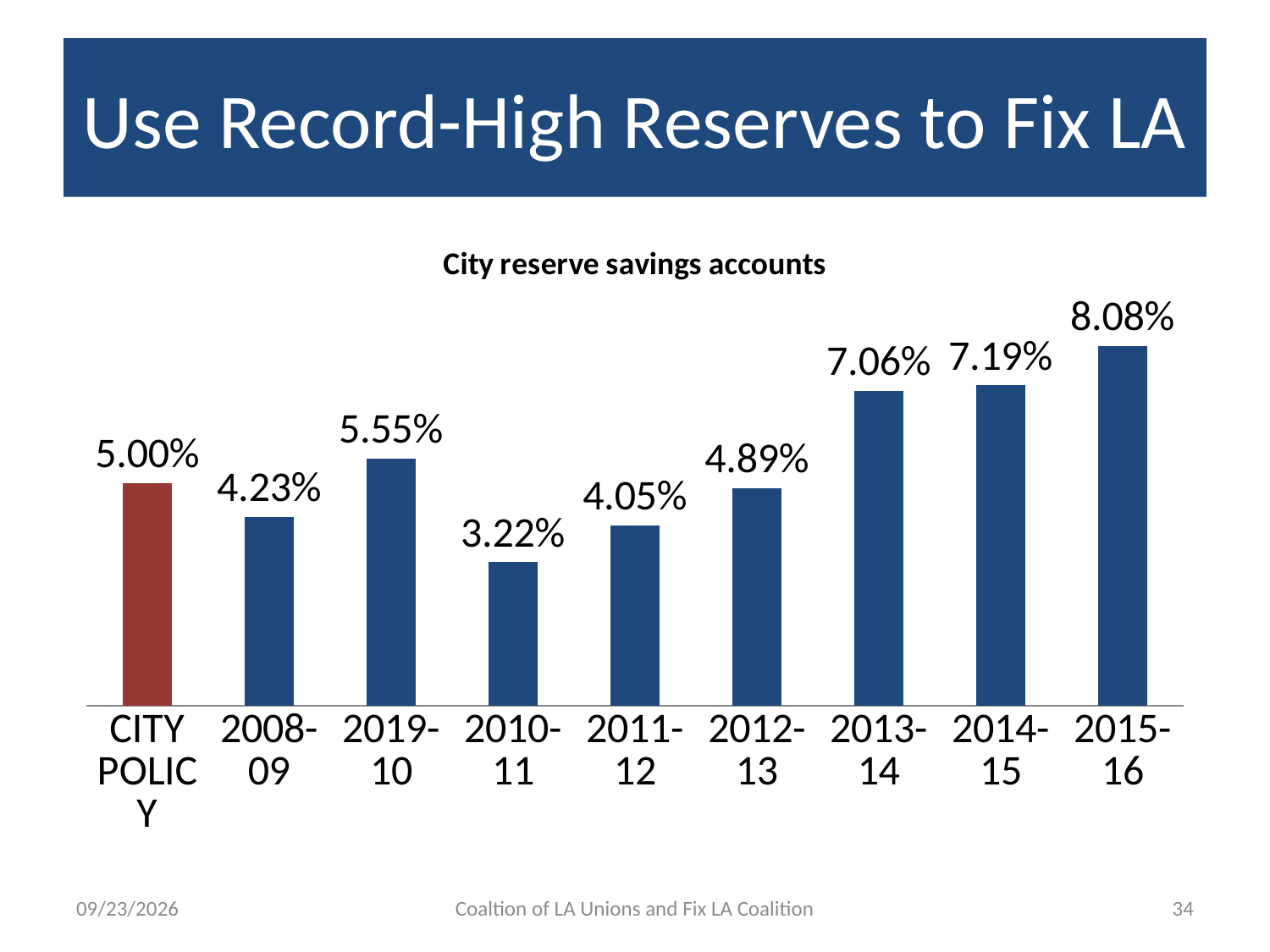
What is the value for CITY POLICY? 5.00% What is the difference between the values for 2013-14 and CITY POLICY? 2.06% What is the value for 2015-16? 8.08% What is the difference between the values for 2015-16 and 2014-15? 0.89% What is the value for 2010-11? 3.22% Which category has the lowest value? 2010-11 What is the title of the chart? City reserve savings accounts Which category has the highest value? 2015-16 What kind of chart is shown on the slide? Bar chart Which is larger, the value for 2012-13 or the value for 2011-12? 2012-13 Do the values generally rise or fall from 2010-11 to 2015-16? Rise How many bars are shown in the chart? 9